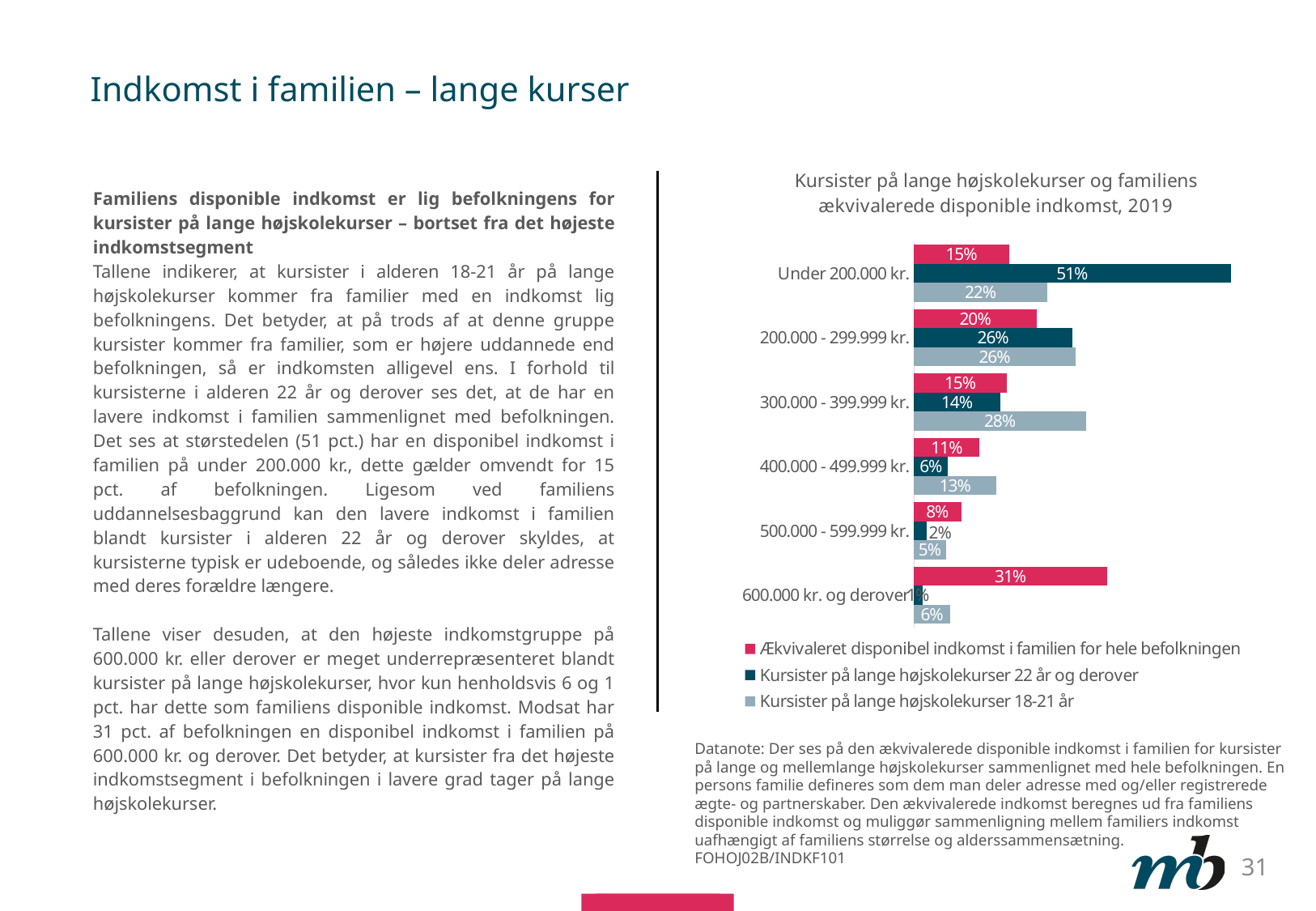
What is the difference between the 'Kursister på lange højskolekurser 22 år og derover' value and the 'hele befolkningen' value in the 'Under 200.000 kr.' category? 36 percentage points What kind of chart is shown on the slide? Bar chart What is the title of the chart? Kursister på lange højskolekurser og familiens ækvivalerede disponible indkomst, 2019 What is the value for 'Ækvivaleret disponibel indkomst i familien for hele befolkningen' in the '600.000 kr. og derover' category? 31% What is the value for 'Kursister på lange højskolekurser 22 år og derover' in the '500.000 - 599.999 kr.' category? 2% How many income categories are shown on the chart? 6 Which income category has the highest value for 'Kursister på lange højskolekurser 22 år og derover'? Under 200.000 kr. How many series does the legend list? 3 In the '400.000 - 499.999 kr.' category, which is larger: the value for 'Kursister på lange højskolekurser 18-21 år' or for 'Kursister på lange højskolekurser 22 år og derover'? Kursister på lange højskolekurser 18-21 år What is the value for 'Kursister på lange højskolekurser 22 år og derover' in the 'Under 200.000 kr.' category? 51% What is the value for 'Kursister på lange højskolekurser 18-21 år' in the '300.000 - 399.999 kr.' category? 28% Which income category has the lowest value for 'Kursister på lange højskolekurser 18-21 år'? 500.000 - 599.999 kr.